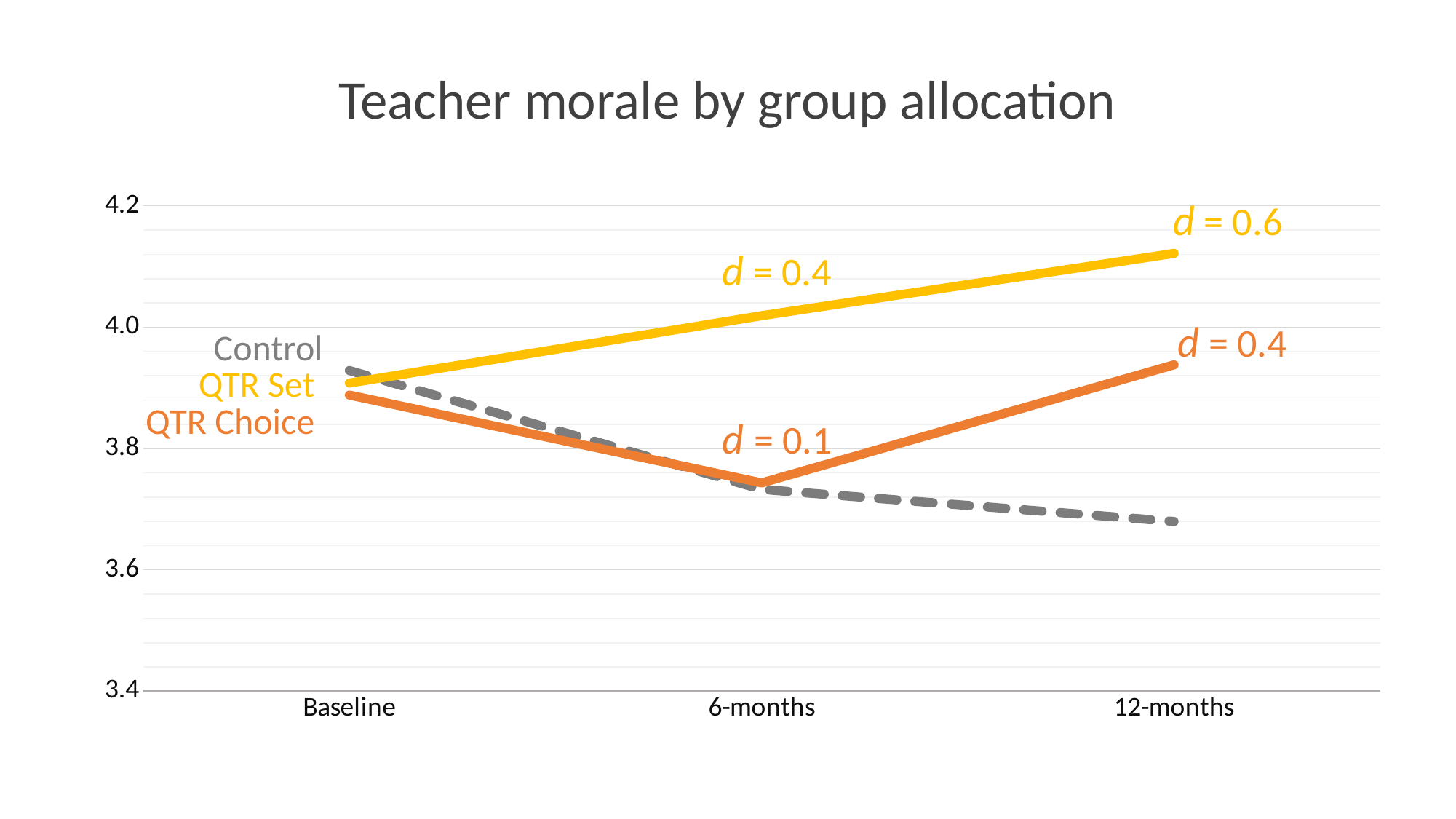
How many time points are shown on the x axis? 3 How many series (groups) are plotted on the chart? 3 What type of chart is shown on the slide? line chart What is the title of the chart? Teacher morale by group allocation Is the value for QTR Set at 12-months greater or less than 4.0? greater Which group has the lowest teacher morale at 12-months? Control At 12-months, which is larger: the value for QTR Choice or the value for Control? QTR Choice What effect size (d) is labelled for QTR Set at 12-months? d = 0.6 Is the value for QTR Choice at 6-months greater or less than 3.8? less Is the value for Control at 12-months greater or less than 3.8? less Which group has the highest teacher morale at 12-months? QTR Set Does the Control group's teacher morale rise or fall from Baseline to 12-months? fall